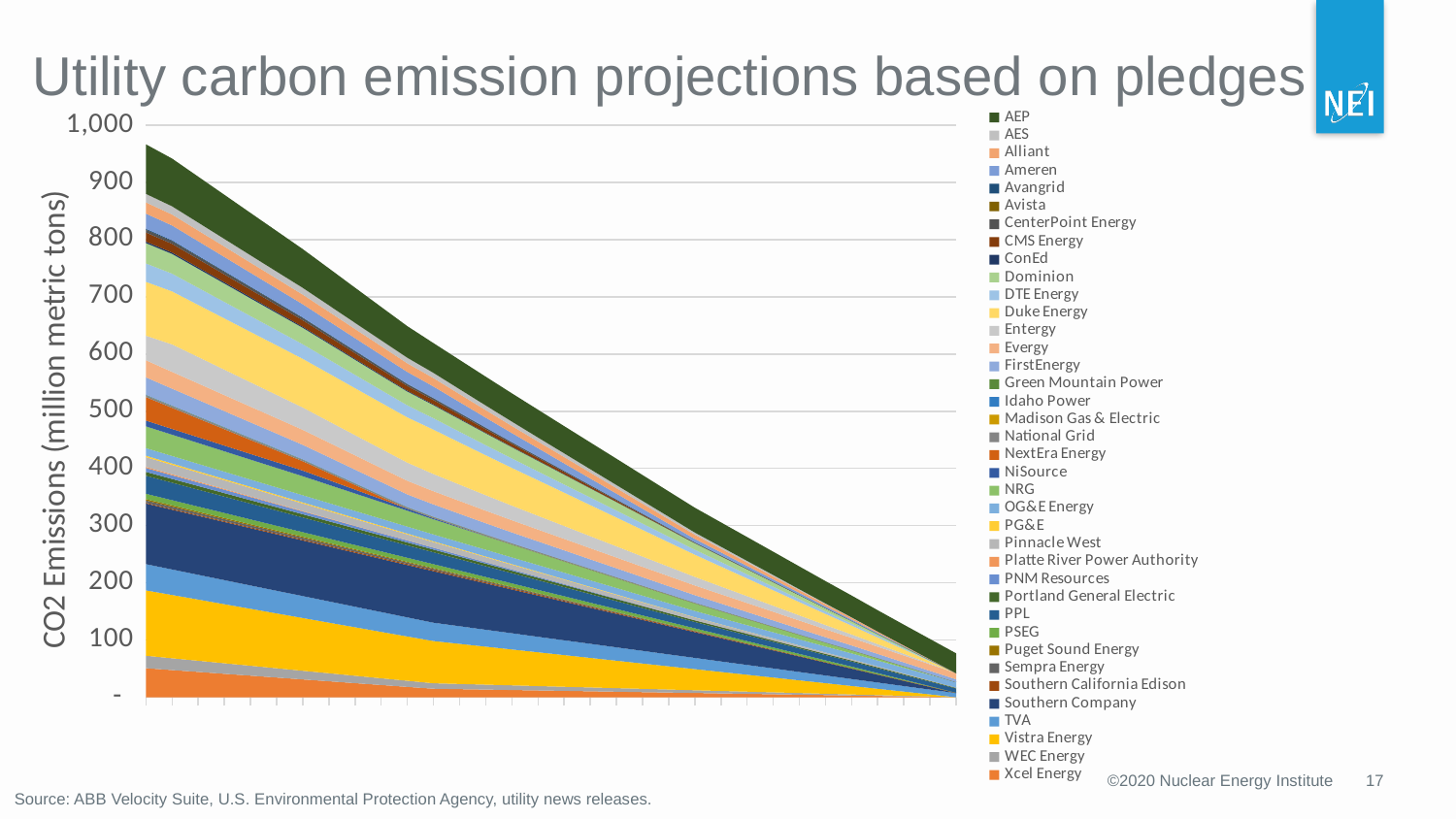
Is the total stacked value at the right end of the chart greater or less than 100? less What is the label on the y axis? CO2 Emissions (million metric tons) What kind of chart is shown on the slide? Stacked area chart Do the total projected emissions rise or fall along the x axis? Fall What is the title of the chart? Utility carbon emission projections based on pledges Is the total stacked value at the left end of the chart greater or less than 900? greater How many series does the legend list? 38 Is the total stacked value at the left end of the chart greater or less than 1,000? less